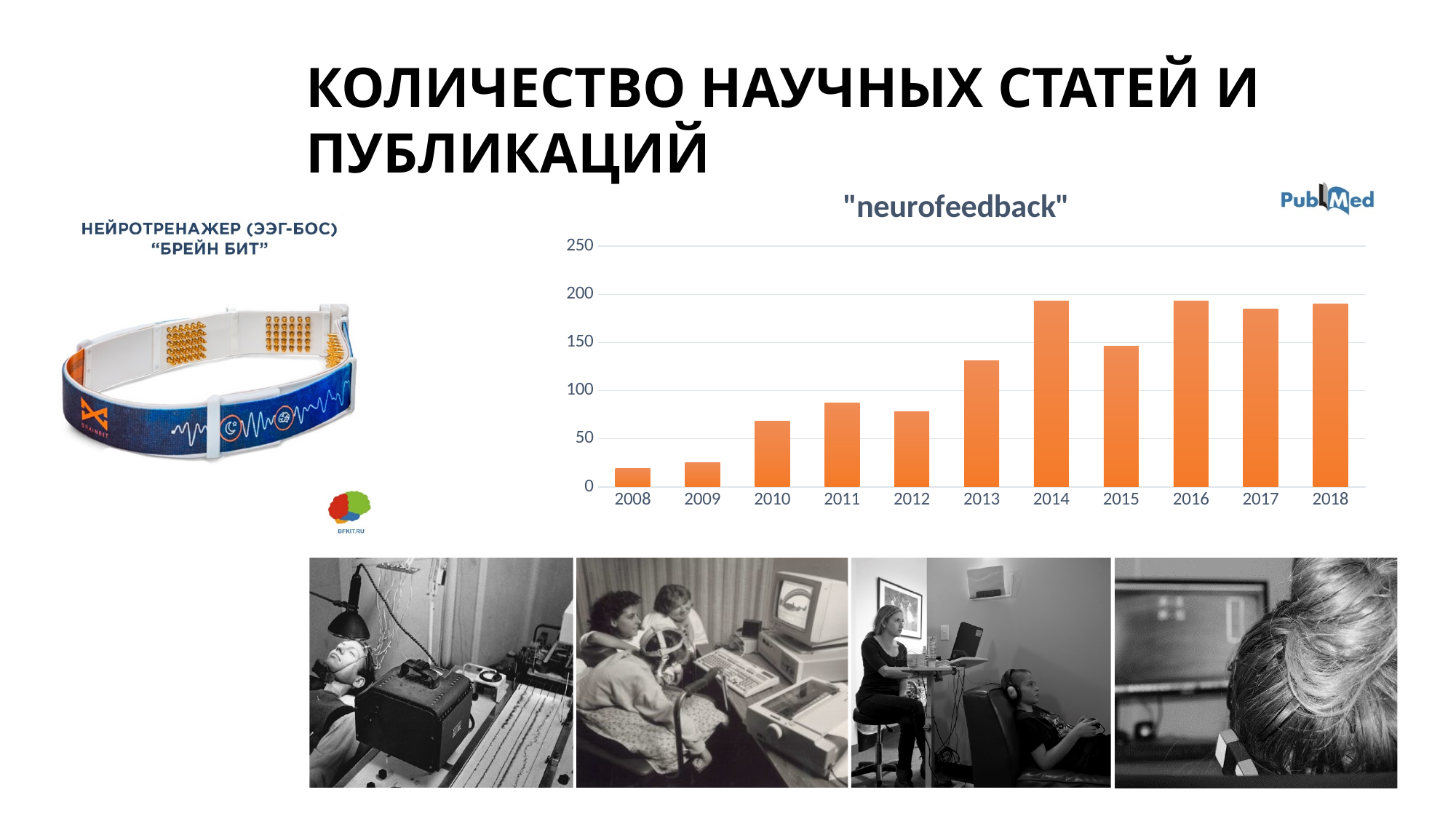
Which year has the larger value, 2014 or 2015? 2014 Is the value for 2015 greater or less than 200? less How many years are shown on the x axis of the chart? 11 What is the title of the chart? "neurofeedback" Which year has the larger value, 2012 or 2013? 2013 What kind of chart is shown on the slide? bar chart Is the value for 2008 greater or less than 50? less Is the value for 2014 greater or less than 150? greater Do the values generally rise or fall from 2008 to 2018? rise Which year has the lowest value in the chart? 2008